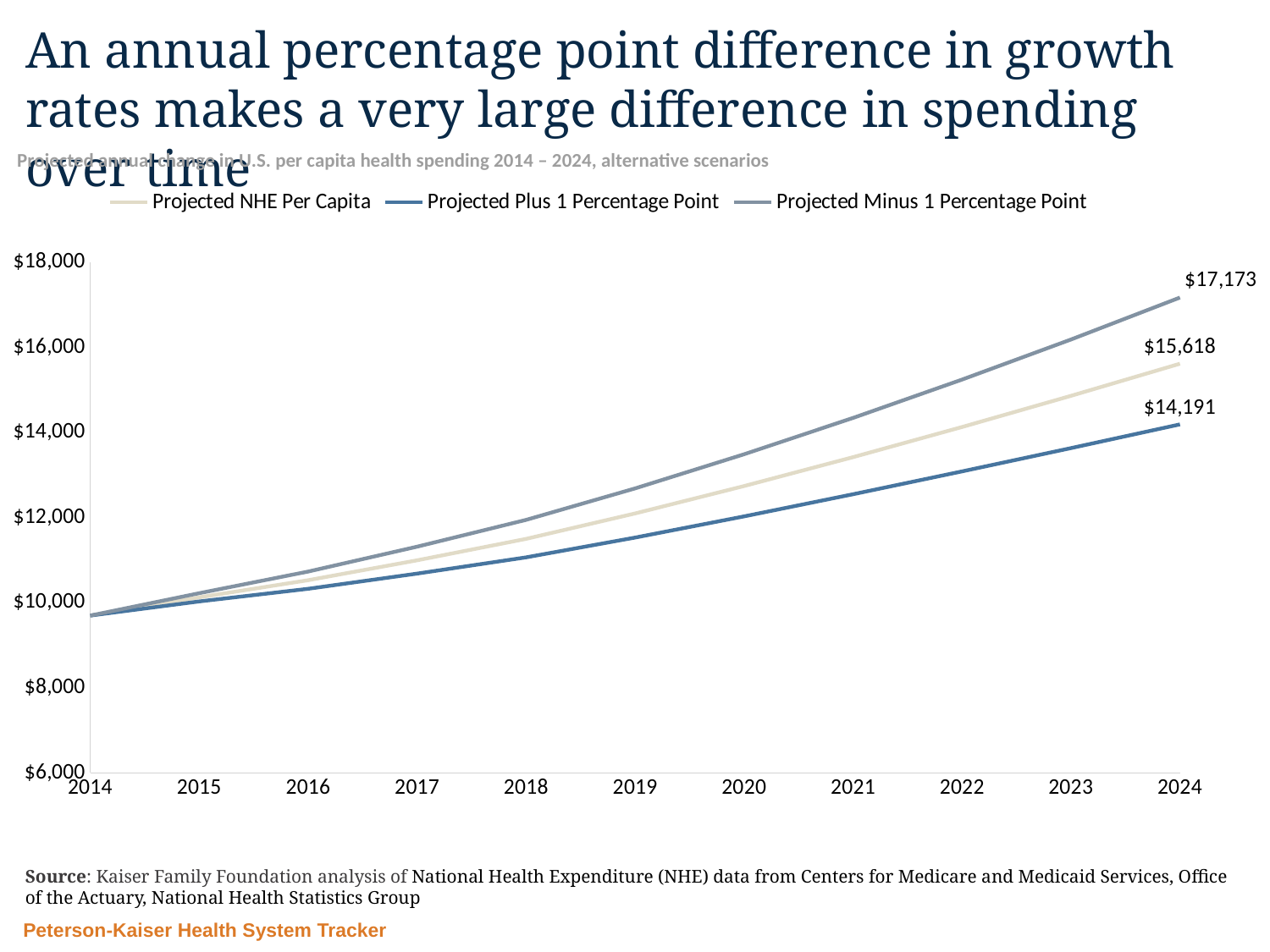
What is the difference between the top 2024 label ($17,173) and the Projected NHE Per Capita 2024 value? $1,555 What is the 2024 value labeled for Projected NHE Per Capita? $15,618 What is the chart's subtitle describing the data? Projected annual change in U.S. per capita health spending 2014 – 2024, alternative scenarios How many years are marked along the x axis? 11 What kind of chart is shown on the slide? line chart What is the difference between the highest and lowest 2024 values labeled on the chart? $2,982 What is the highest value labeled on the chart in 2024? $17,173 How many series does the legend list? 3 What is the lowest value labeled on the chart in 2024? $14,191 Is the value for Projected NHE Per Capita in 2020 greater or less than $12,000? greater Is the value for Projected NHE Per Capita in 2014 greater or less than $10,000? less Do the lines rise or fall from 2014 to 2024? rise